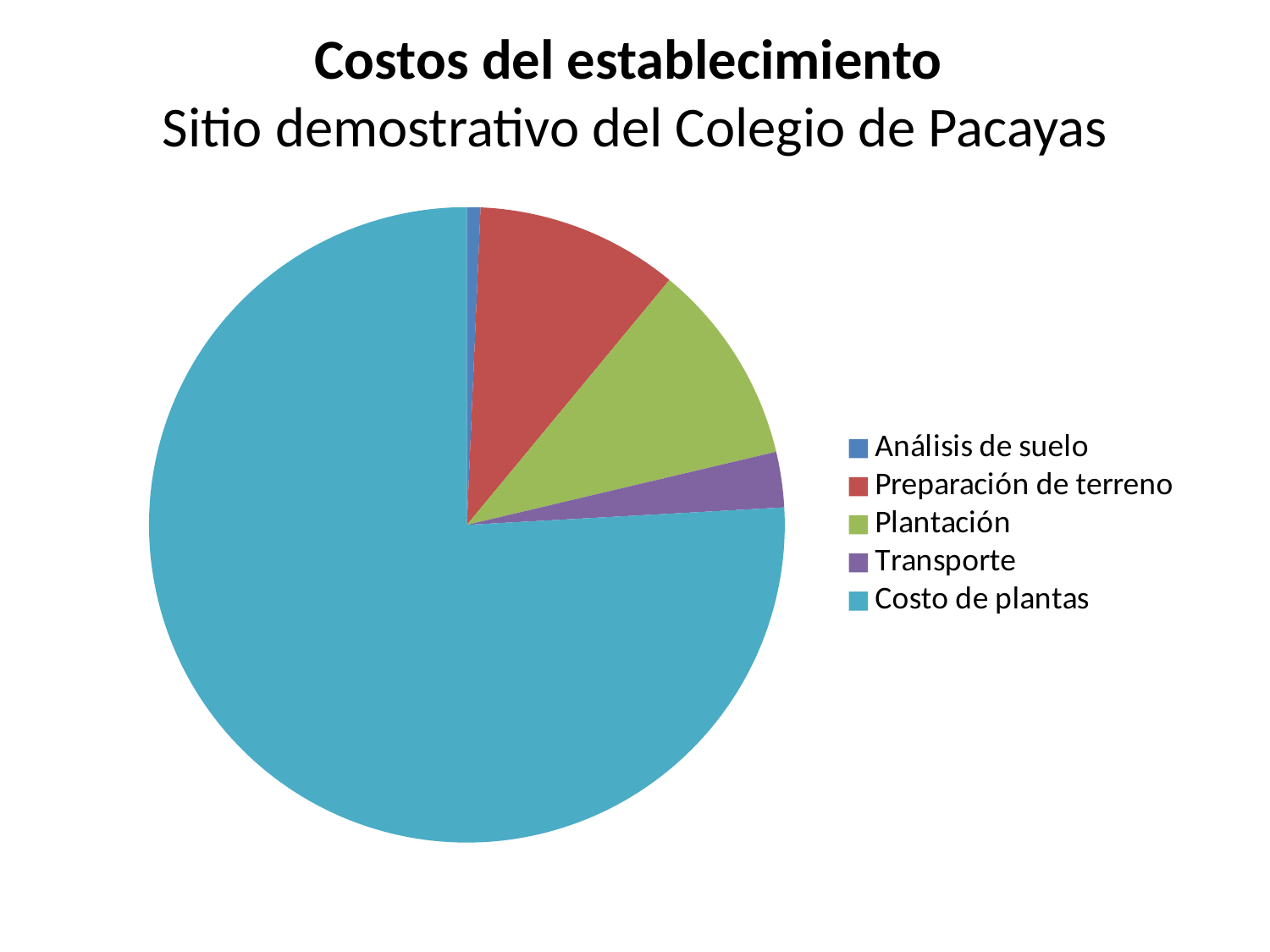
Which is larger in the pie chart, Plantación or Transporte? Plantación Which category has the smallest slice of the pie chart? Análisis de suelo How many categories (slices) does the pie chart have? 5 How many entries does the legend of the pie chart list? 5 What is the bold title of the chart on the slide? Costos del establecimiento Which is larger in the pie chart, Costo de plantas or Plantación? Costo de plantas Which category has the largest slice of the pie chart? Costo de plantas What kind of chart is shown on the slide? Pie chart Which is larger in the pie chart, Costo de plantas or Preparación de terreno? Costo de plantas Which category is shown in red in the pie chart? Preparación de terreno